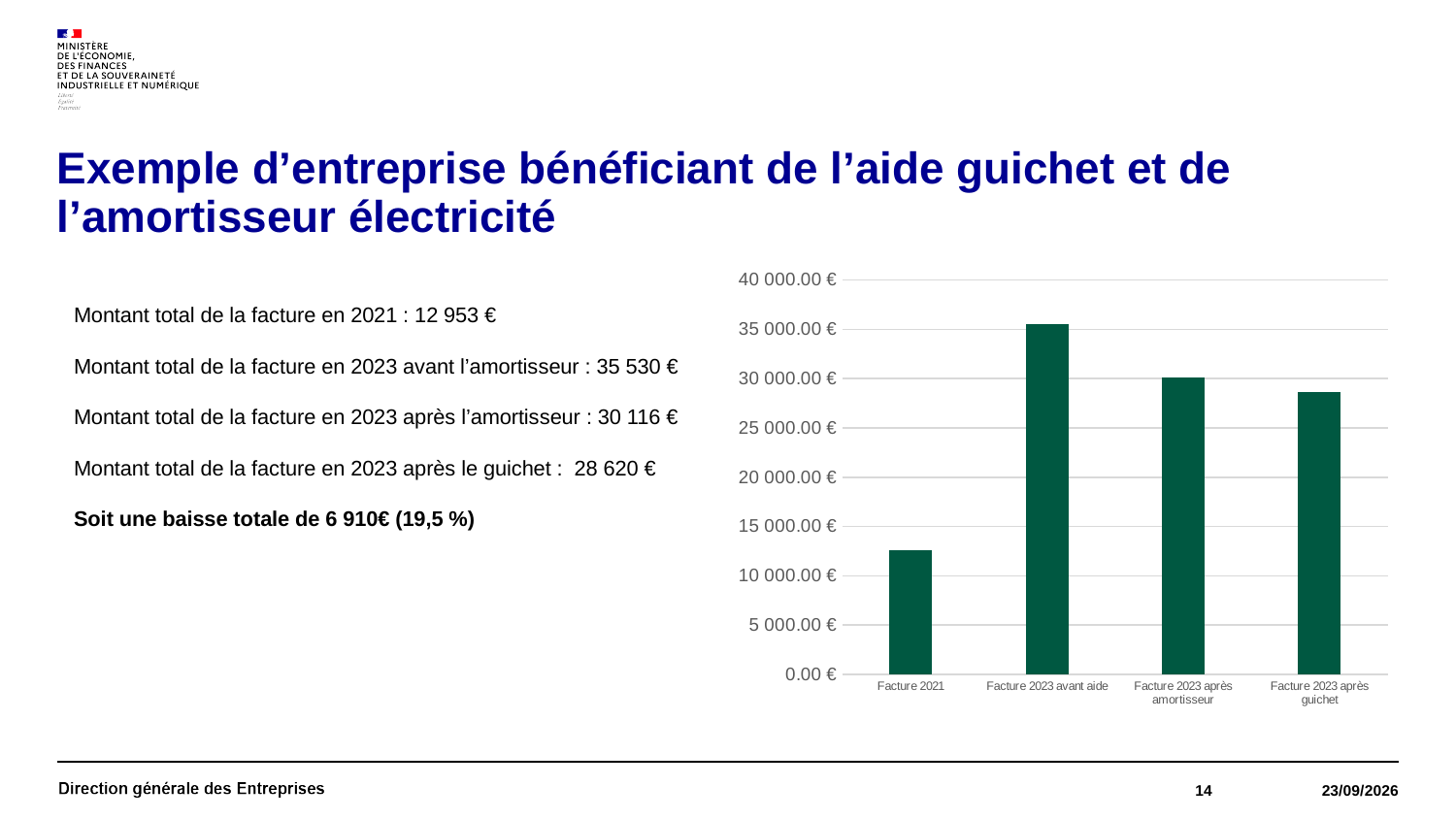
According to the slide text, what is the total bill amount for 2023 before the amortisseur (Facture 2023 avant aide)? 35 530 € How many bars does the chart have? 4 Is the value for Facture 2023 après amortisseur greater or less than 25 000.00 €? greater Which category has the lowest bar? Facture 2021 Which category has the highest bar? Facture 2023 avant aide Is the value for Facture 2021 greater or less than 15 000.00 €? less Is the value for Facture 2023 avant aide greater or less than 35 000.00 €? greater Which is larger, the bar for Facture 2023 après amortisseur or the bar for Facture 2023 après guichet? Facture 2023 après amortisseur What kind of chart is shown on the slide? bar chart According to the slide text, what is the total bill amount for 2023 after the guichet? 28 620 € What is the total decrease between the 2023 bill before aid and the 2023 bill after the guichet, as stated on the slide? 6 910€ (19,5 %)